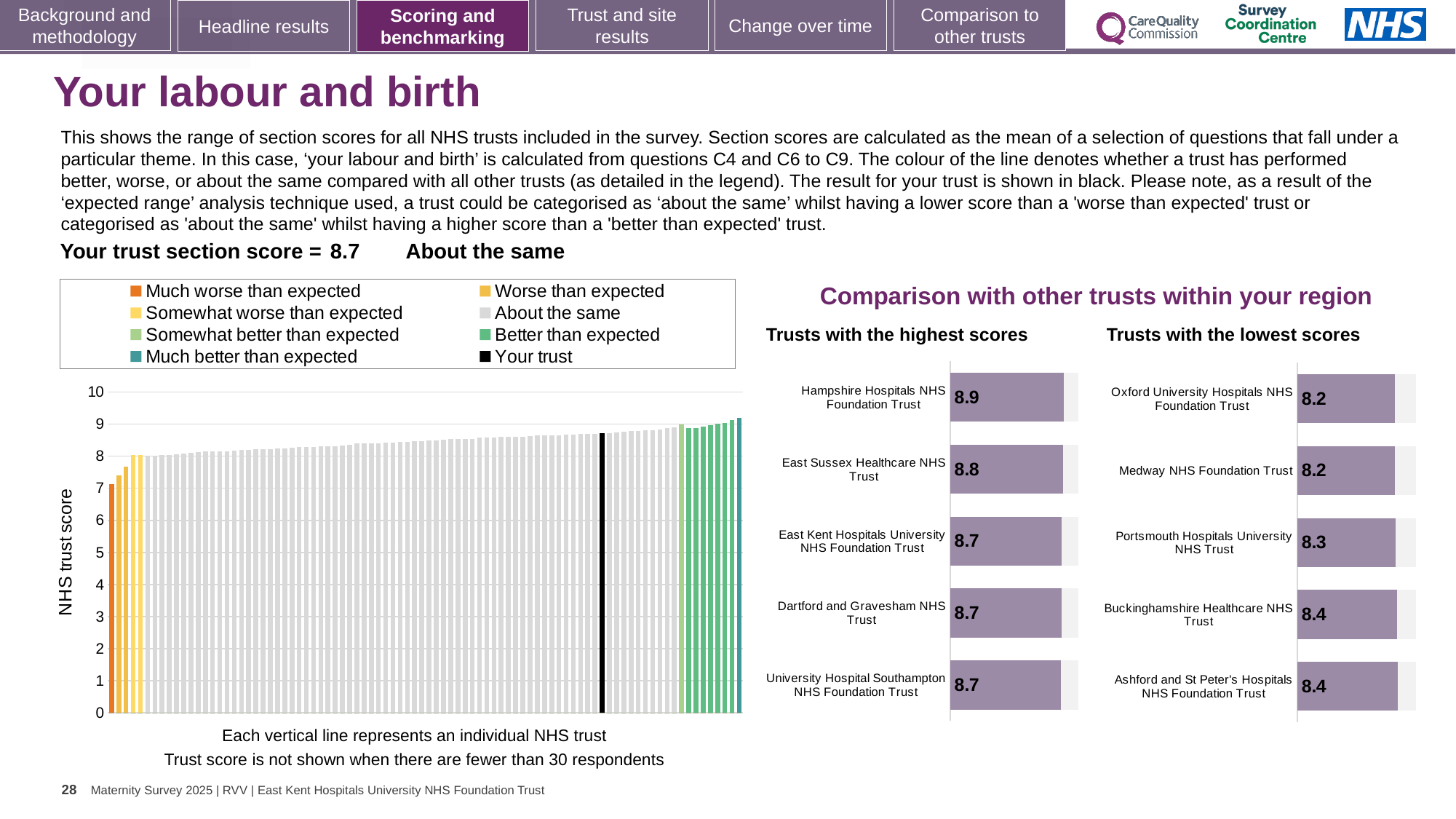
In the 'Trusts with the highest scores' chart, how many trusts are shown? 5 In the large chart on the left, is the value for the black 'Your trust' bar greater or less than 8? greater In the 'Trusts with the lowest scores' chart, what is the difference between the scores of Ashford and St Peter's Hospitals NHS Foundation Trust and Oxford University Hospitals NHS Foundation Trust? 0.2 In the 'Trusts with the highest scores' chart, what is the difference between the scores of Hampshire Hospitals NHS Foundation Trust and University Hospital Southampton NHS Foundation Trust? 0.2 What kind of chart is the large chart on the left showing NHS trust scores? Bar chart In the 'Trusts with the lowest scores' chart, what is the score for Medway NHS Foundation Trust? 8.2 In the 'Trusts with the highest scores' chart, which trust has the highest score? Hampshire Hospitals NHS Foundation Trust In the 'Trusts with the lowest scores' chart, which has the larger score: Portsmouth Hospitals University NHS Trust or Oxford University Hospitals NHS Foundation Trust? Portsmouth Hospitals University NHS Trust In the large chart on the left, how many entries does the legend list? 8 In the 'Trusts with the highest scores' chart, what is the score for Hampshire Hospitals NHS Foundation Trust? 8.9 In the 'Trusts with the highest scores' chart, what is the score for East Sussex Healthcare NHS Trust? 8.8 In the 'Trusts with the lowest scores' chart, what is the score for Portsmouth Hospitals University NHS Trust? 8.3